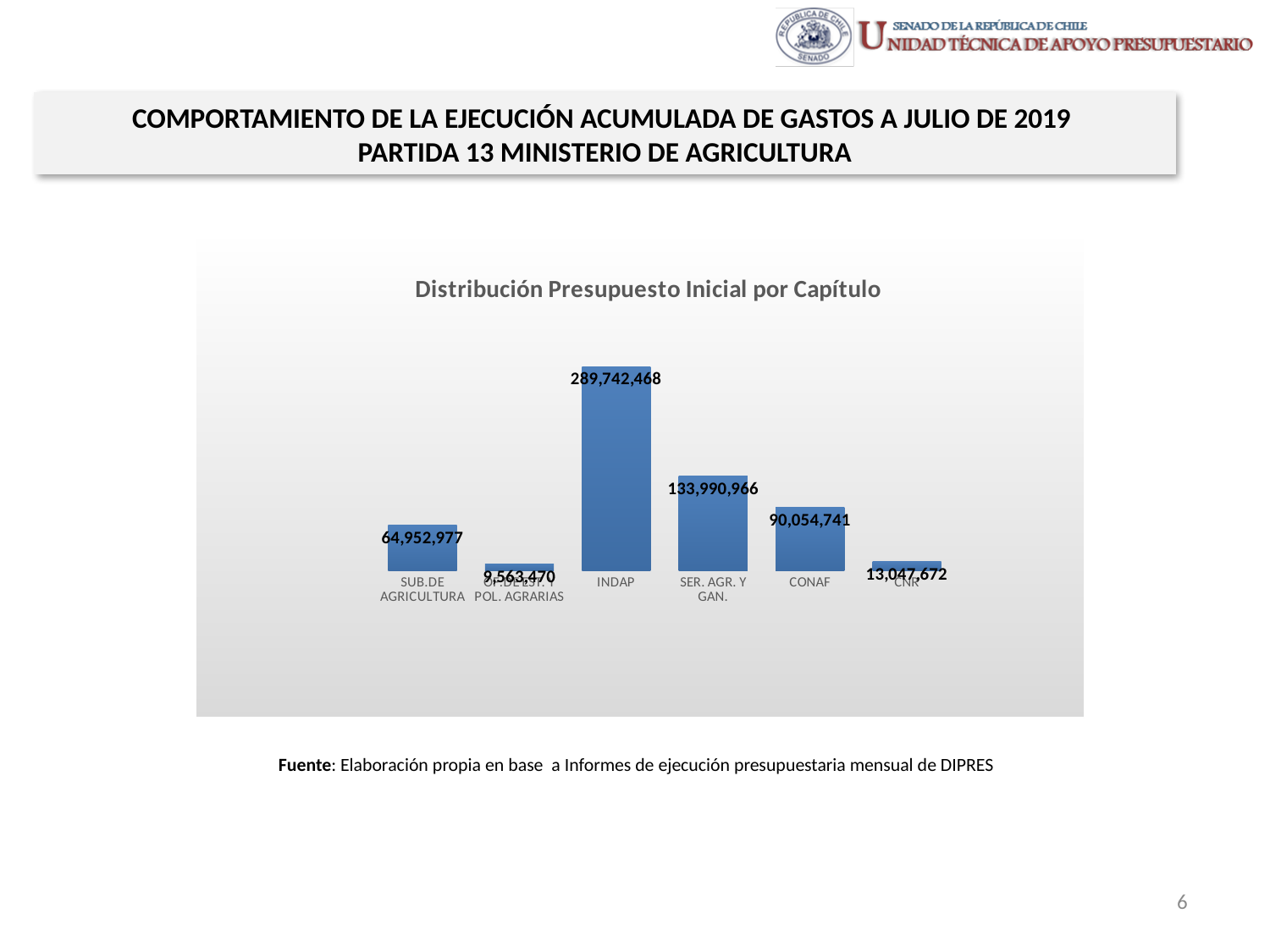
Which is larger, the value for CNR or the value for SUB.DE AGRICULTURA? SUB.DE AGRICULTURA What is the title of the chart? Distribución Presupuesto Inicial por Capítulo What is the value for SER. AGR. Y GAN.? 133,990,966 Which category has the highest value in the chart? INDAP What is the value for INDAP in the chart? 289,742,468 What is the difference between the values for INDAP and SER. AGR. Y GAN.? 155,751,502 What is the difference between the values for CONAF and SUB.DE AGRICULTURA? 25,101,764 What is the lowest value shown in the chart? 9,563,470 What is the value for CNR? 13,047,672 How many categories are shown in the chart? 6 What is the value for CONAF? 90,054,741 What is the value for SUB.DE AGRICULTURA? 64,952,977